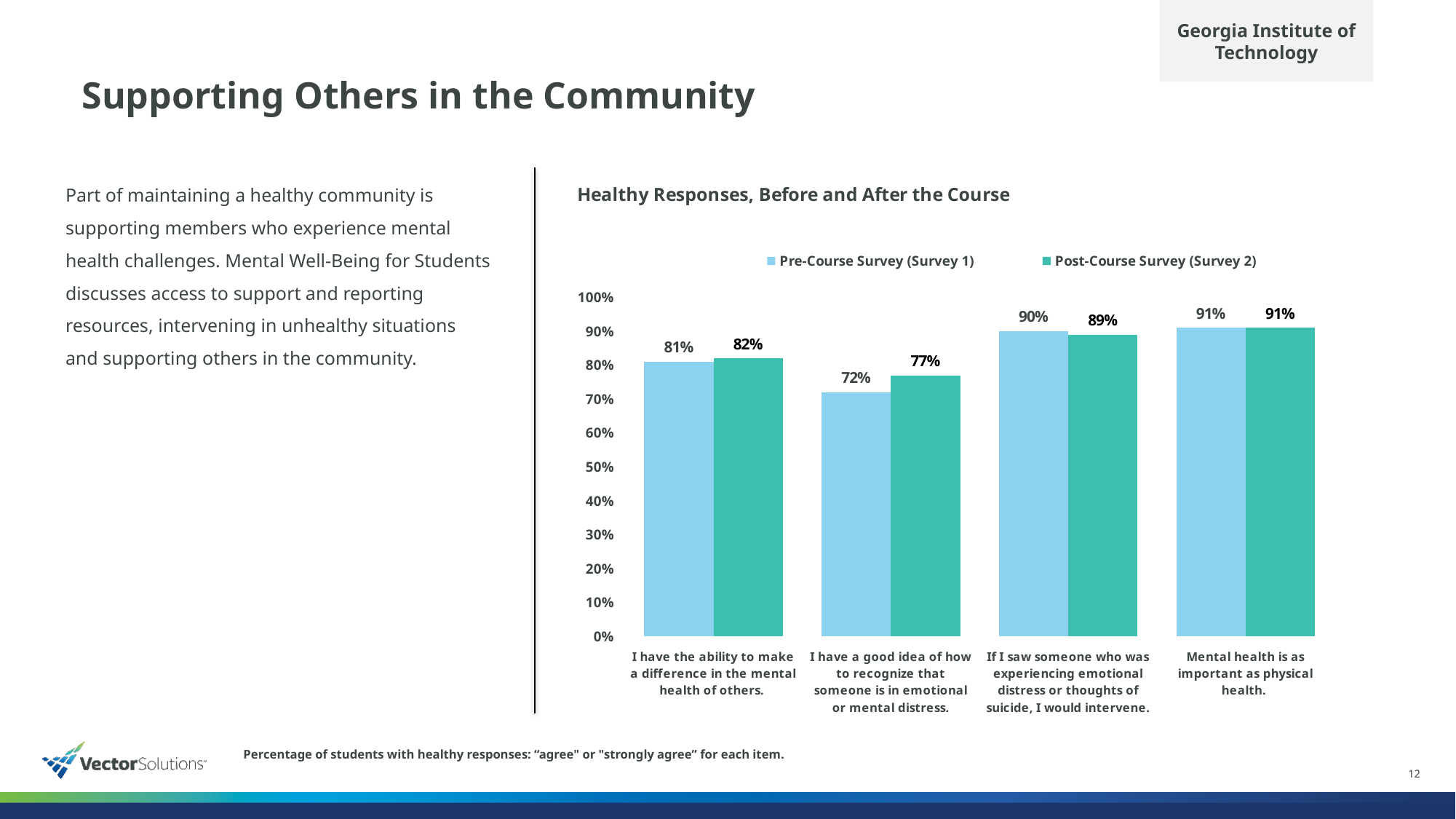
What is the Post-Course Survey (Survey 2) value for "If I saw someone who was experiencing emotional distress or thoughts of suicide, I would intervene."? 89% What is the difference between the Post-Course and Pre-Course Survey values for "I have a good idea of how to recognize that someone is in emotional or mental distress."? 5% Is the Pre-Course Survey (Survey 1) value for "I have the ability to make a difference in the mental health of others." greater or less than 70%? greater What kind of chart is shown on the slide? Bar chart For "If I saw someone who was experiencing emotional distress or thoughts of suicide, I would intervene.", which is larger: the Pre-Course Survey value or the Post-Course Survey value? Pre-Course Survey (Survey 1) Which category has the lowest Pre-Course Survey (Survey 1) value? I have a good idea of how to recognize that someone is in emotional or mental distress. What is the Pre-Course Survey (Survey 1) value for "I have a good idea of how to recognize that someone is in emotional or mental distress."? 72% How many categories are shown on the x axis of the chart? 4 What is the Post-Course Survey (Survey 2) value for "I have the ability to make a difference in the mental health of others."? 82% Which category has the highest Post-Course Survey (Survey 2) value? Mental health is as important as physical health. How many series does the chart's legend list? 2 What is the title of the chart? Healthy Responses, Before and After the Course